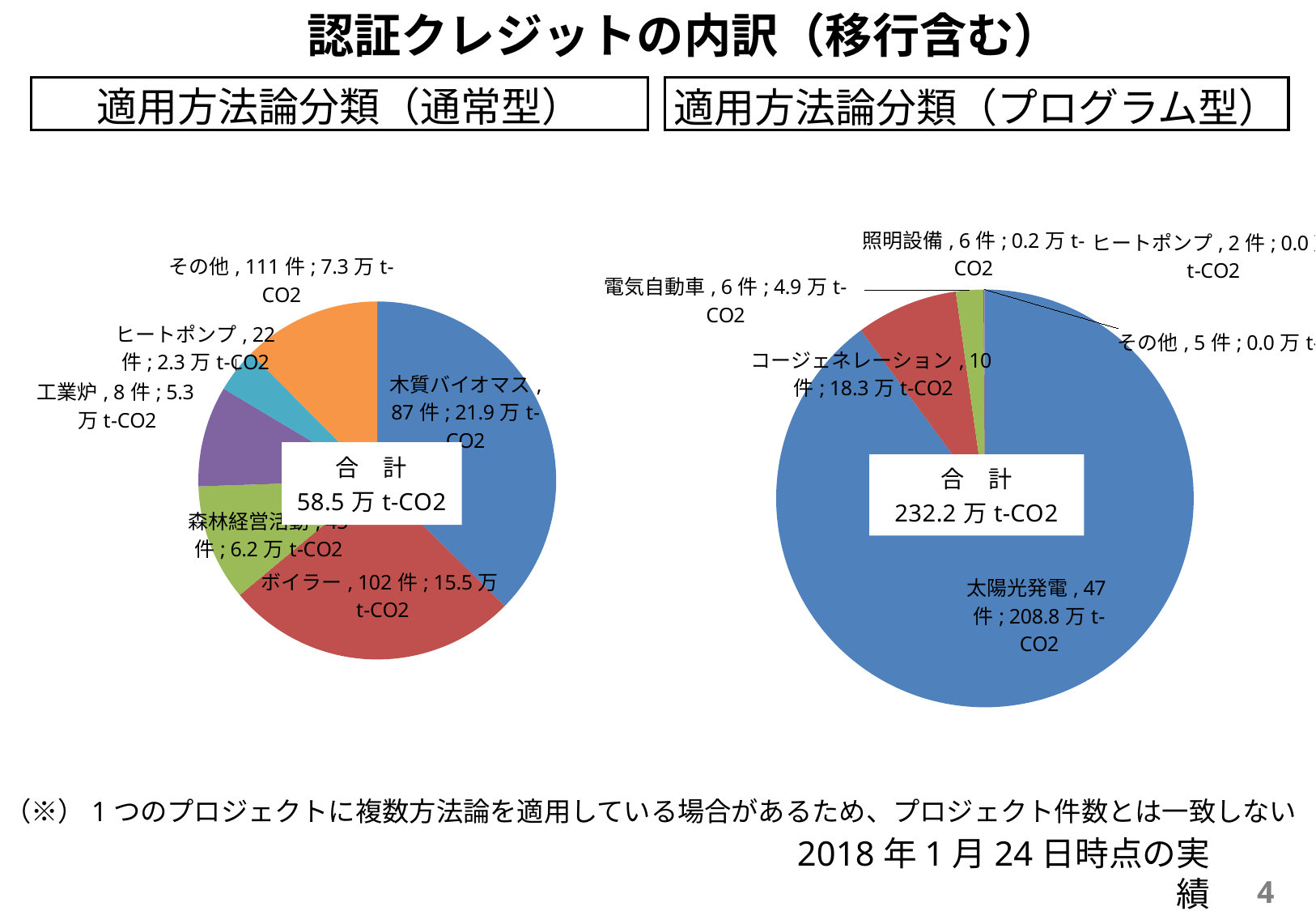
In the right pie chart (適用方法論分類（プログラム型）), which is larger in credit amount, 電気自動車 or 照明設備? 電気自動車 In the left pie chart (適用方法論分類（通常型）), what is the difference in credit amount between 木質バイオマス and ボイラー? 6.4 万 t-CO2 In the left pie chart (適用方法論分類（通常型）), how many 件 are listed for ボイラー? 102 件 In the right pie chart (適用方法論分類（プログラム型）), how many 件 are listed for コージェネレーション? 10 件 In the left pie chart (適用方法論分類（通常型）), how many slices does the pie have? 6 In the right pie chart (適用方法論分類（プログラム型）), what is the total (合計) shown in the centre? 232.2 万 t-CO2 What type of chart is used on this slide? Pie chart In the left pie chart (適用方法論分類（通常型）), which category has the smallest credit amount? ヒートポンプ In the left pie chart (適用方法論分類（通常型）), what is the credit amount for 木質バイオマス? 21.9 万 t-CO2 In the right pie chart (適用方法論分類（プログラム型）), what is the credit amount for 太陽光発電? 208.8 万 t-CO2 In the left pie chart (適用方法論分類（通常型）), which category has the largest credit amount? 木質バイオマス In the left pie chart (適用方法論分類（通常型）), what is the total (合計) shown in the centre? 58.5 万 t-CO2